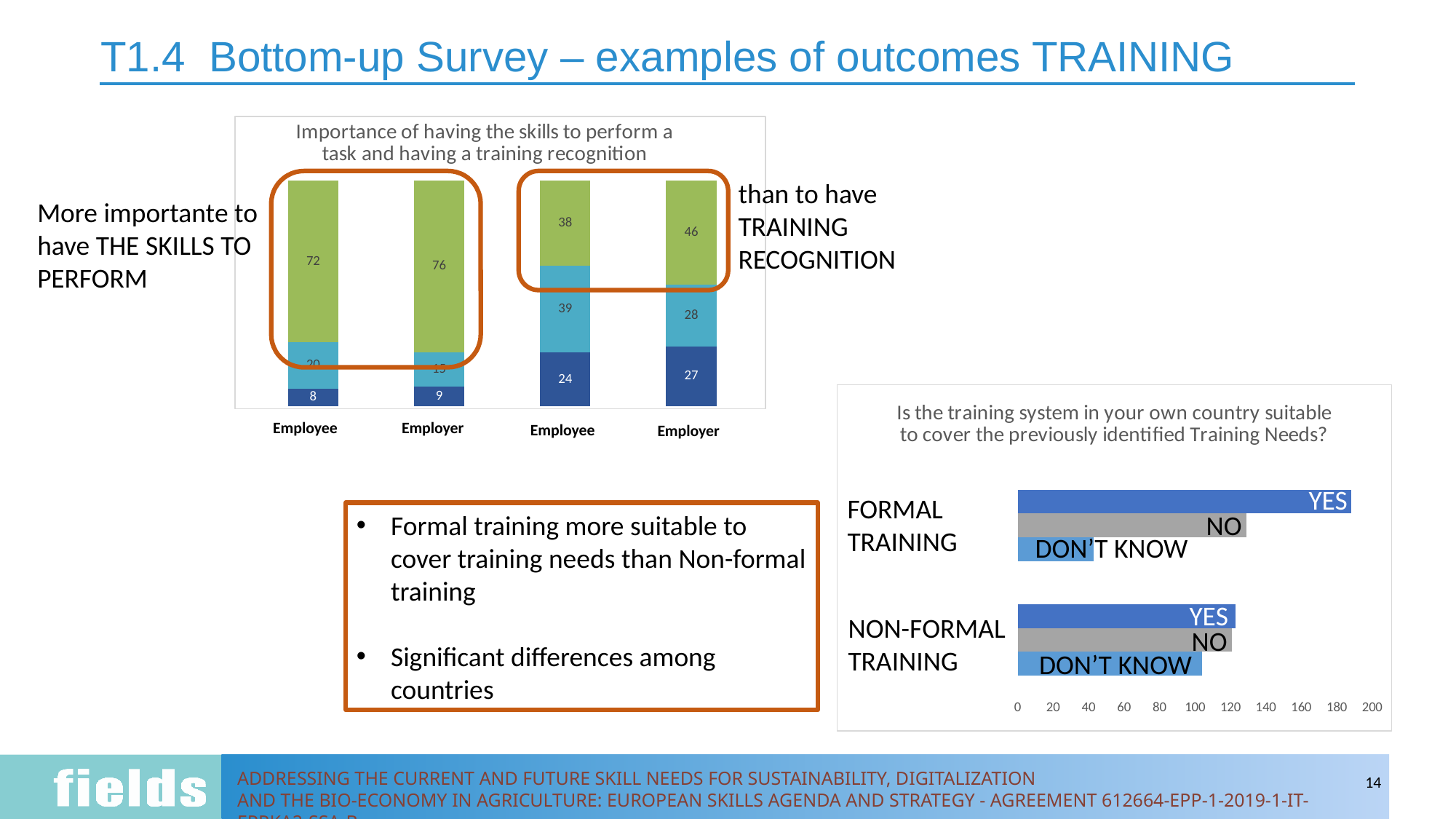
In the chart titled 'Importance of having the skills to perform a task and having a training recognition', what is the total of the first Employee bar (72, 20 and 8)? 100 In the chart titled 'Importance of having the skills to perform a task and having a training recognition', what is the value of the light blue (middle) segment of the second Employee bar? 39 In the chart titled 'Importance of having the skills to perform a task and having a training recognition', what is the difference between the green segments of the second Employer bar (46) and the second Employee bar (38)? 8 In the chart titled 'Is the training system in your own country suitable to cover the previously identified Training Needs?', which is larger: the YES value for FORMAL TRAINING or the YES value for NON-FORMAL TRAINING? FORMAL TRAINING In the chart titled 'Is the training system in your own country suitable to cover the previously identified Training Needs?', which is larger: the DON'T KNOW value for FORMAL TRAINING or the DON'T KNOW value for NON-FORMAL TRAINING? NON-FORMAL TRAINING In the chart titled 'Importance of having the skills to perform a task and having a training recognition', what is the value of the green (top) segment of the first Employee bar? 72 In the chart titled 'Importance of having the skills to perform a task and having a training recognition', how many stacked bars are plotted? 4 What kind of chart is the one titled 'Importance of having the skills to perform a task and having a training recognition'? Stacked bar chart In the chart titled 'Is the training system in your own country suitable to cover the previously identified Training Needs?', is the YES value for FORMAL TRAINING greater or less than 160? greater In the chart titled 'Importance of having the skills to perform a task and having a training recognition', what is the value of the green (top) segment of the first Employer bar? 76 In the chart titled 'Importance of having the skills to perform a task and having a training recognition', what is the value of the dark blue (bottom) segment of the second Employer bar? 27 In the chart titled 'Is the training system in your own country suitable to cover the previously identified Training Needs?', is the DON'T KNOW value for FORMAL TRAINING greater or less than 60? less